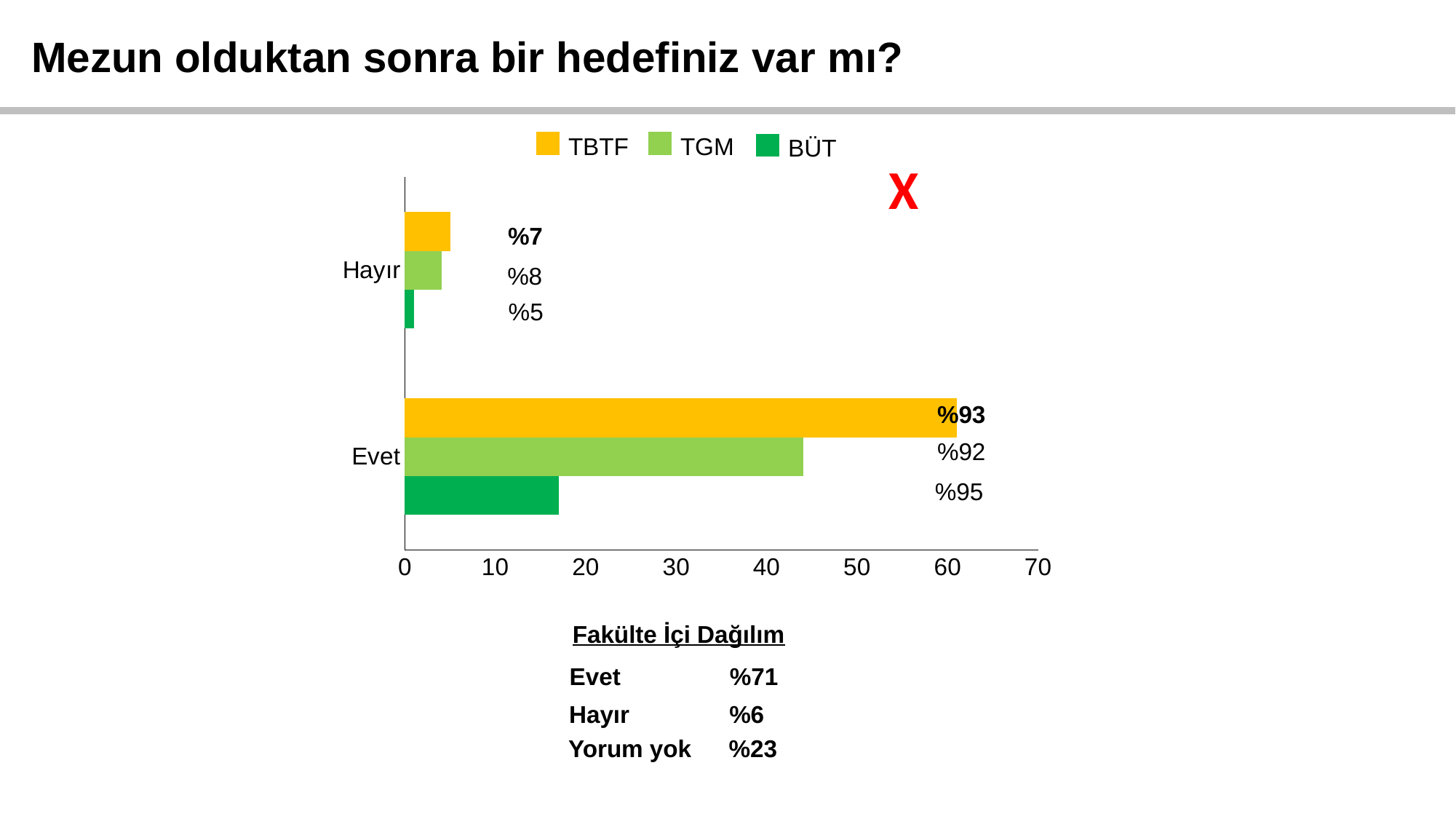
What percentage label is shown for BÜT in the Hayır category? %5 What percentage label is shown for BÜT in the Evet category? %95 What kind of chart is shown on the slide? bar chart Which series has the longest bar in the Evet category? TBTF What percentage label is shown for TBTF in the Evet category? %93 What are the three series named in the chart legend? TBTF, TGM, BÜT How many series does the chart legend list? 3 In the Evet category, is the BÜT bar greater or less than 20 on the horizontal axis? less What percentage label is shown for TGM in the Hayır category? %8 How many categories are shown on the chart's vertical axis? 2 In the Evet category, is the TGM bar greater or less than 40 on the horizontal axis? greater Which series has the shortest bar in the Evet category? BÜT